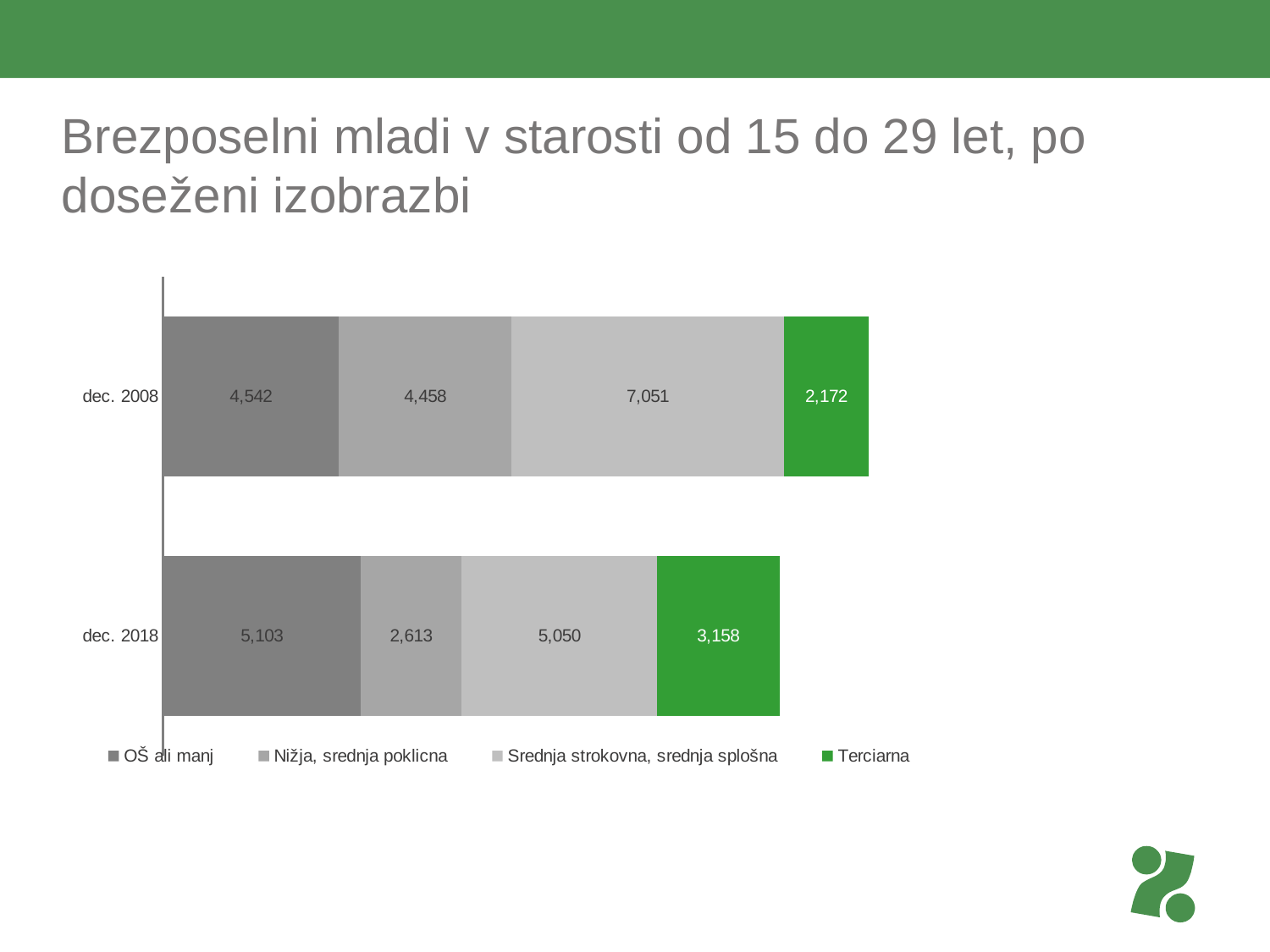
What is the total of the dec. 2008 stacked bar? 18,223 Which education level has the largest segment in the dec. 2008 bar? Srednja strokovna, srednja splošna What is the difference between the Terciarna values for dec. 2018 and dec. 2008? 986 Which education level has the smallest segment in the dec. 2018 bar? Nižja, srednja poklicna What is the difference between the Srednja strokovna, srednja splošna values for dec. 2008 and dec. 2018? 2,001 What is the value for Nižja, srednja poklicna in dec. 2008? 4,458 Which is larger: OŠ ali manj in dec. 2008 or OŠ ali manj in dec. 2018? dec. 2018 How many series does the legend list? 4 What is the value for Terciarna in dec. 2008? 2,172 What is the value for Srednja strokovna, srednja splošna in dec. 2018? 5,050 What is the value for OŠ ali manj in dec. 2018? 5,103 What is the total of the dec. 2018 stacked bar? 15,924